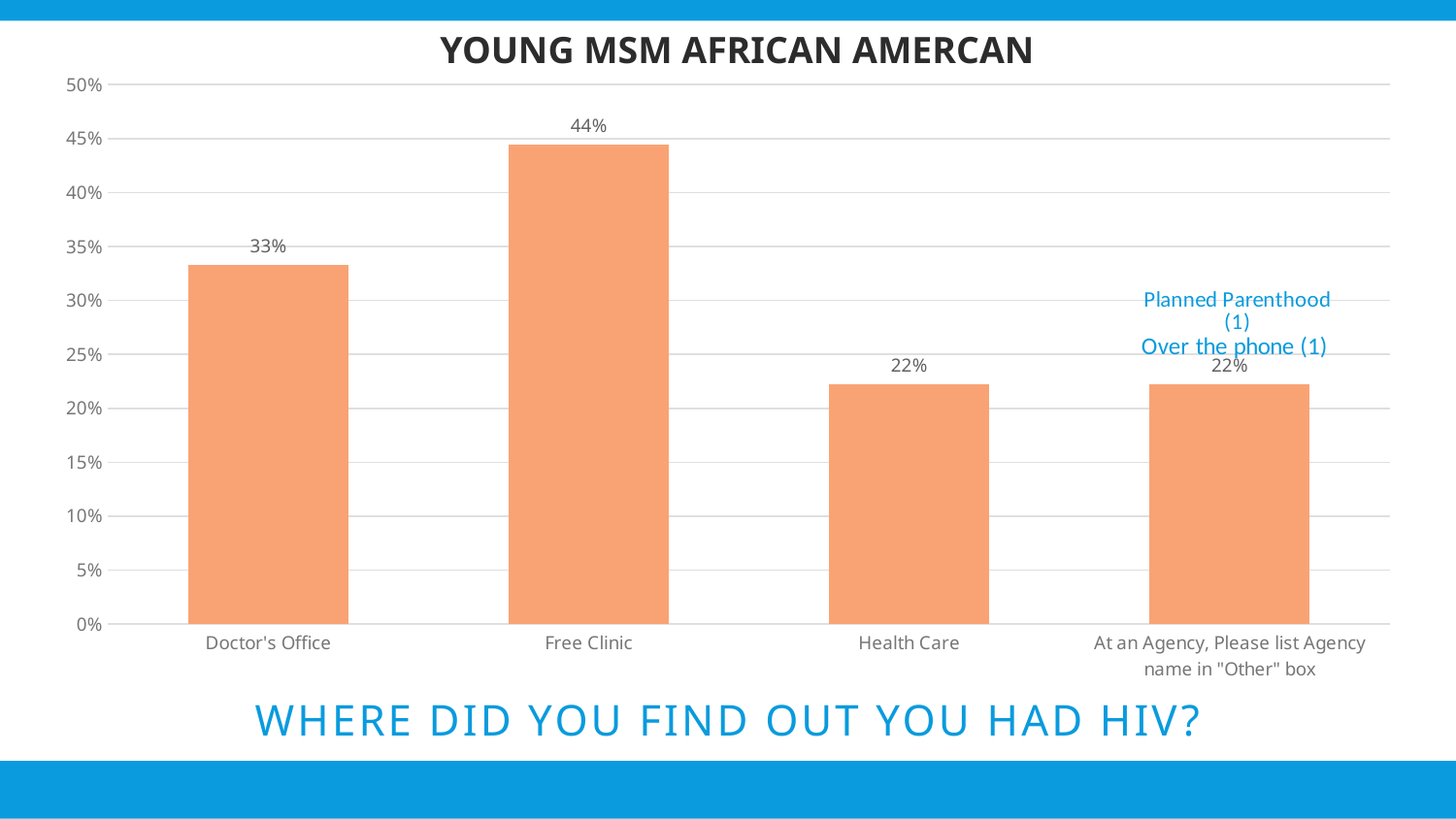
What kind of chart is shown on the slide? bar chart What is the value for Free Clinic? 44% What is the title of the chart? YOUNG MSM AFRICAN AMERCAN What is the value for the category 'At an Agency, Please list Agency name in "Other" box'? 22% Is the value for Free Clinic greater or less than 40%? greater Which is larger, the value for Doctor's Office or the value for Health Care? Doctor's Office What is the value for Health Care? 22% How many categories are shown on the x axis? 4 What is the value for Doctor's Office? 33% What is the difference between the values for Free Clinic and Doctor's Office? 11% What is the difference between the values for Doctor's Office and Health Care? 11% Which category has the highest value? Free Clinic